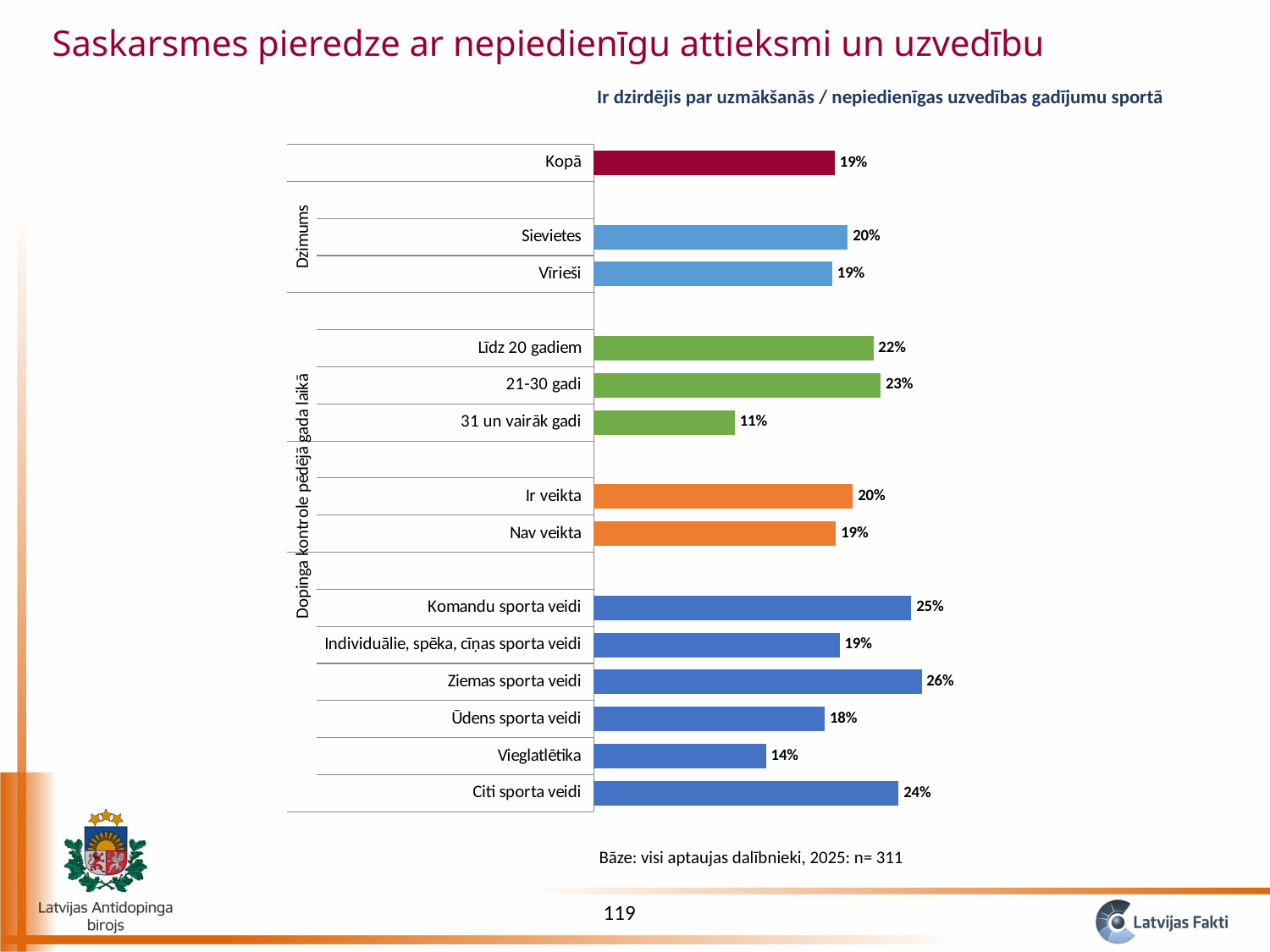
What is the value for Ziemas sporta veidi? 26% Which category has the highest value? Ziemas sporta veidi What is the value for Vieglatlētika? 14% Which is larger, the value for Sievietes or the value for Vīrieši? Sievietes Which category has the lowest value? 31 un vairāk gadi Which is larger, the value for Citi sporta veidi or the value for Ūdens sporta veidi? Citi sporta veidi What kind of chart is shown on the slide? Bar chart What is the difference between the values for Komandu sporta veidi and Vieglatlētika? 11% What is the value for 31 un vairāk gadi? 11% What is the difference between the values for 21-30 gadi and 31 un vairāk gadi? 12% What is the value for Kopā? 19% How many bars are plotted in the chart? 14